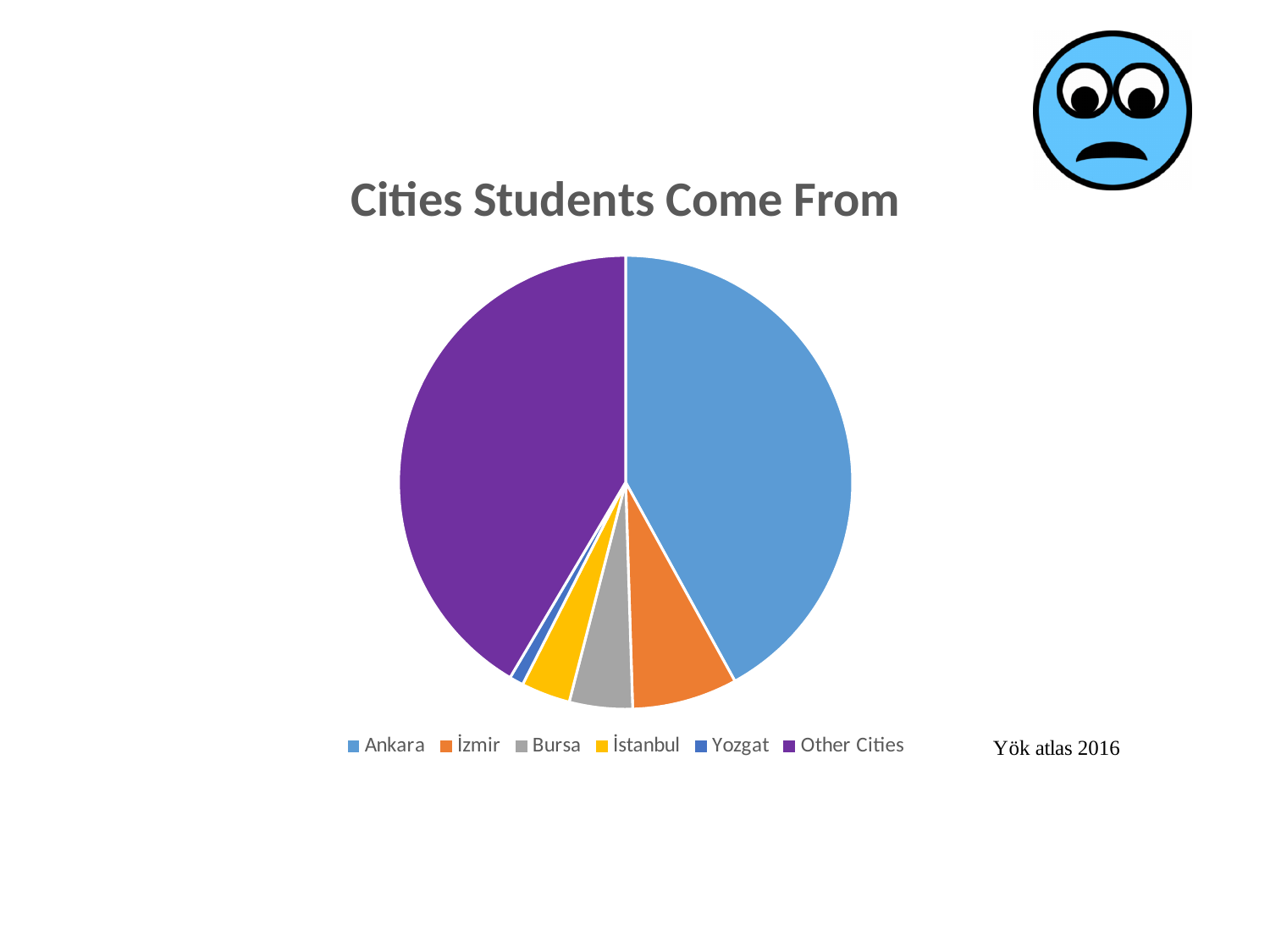
Which slice is larger, Other Cities or İstanbul? Other Cities How many slices does the pie chart have? 6 Which category is listed last in the legend? Other Cities Which slice is larger, Ankara or İzmir? Ankara What kind of chart is shown on the slide? Pie chart Which slice is larger, İzmir or Bursa? İzmir Which category has the smallest slice in the pie chart? Yozgat What colour is the Ankara slice in the pie chart? Blue What is the title of the chart? Cities Students Come From